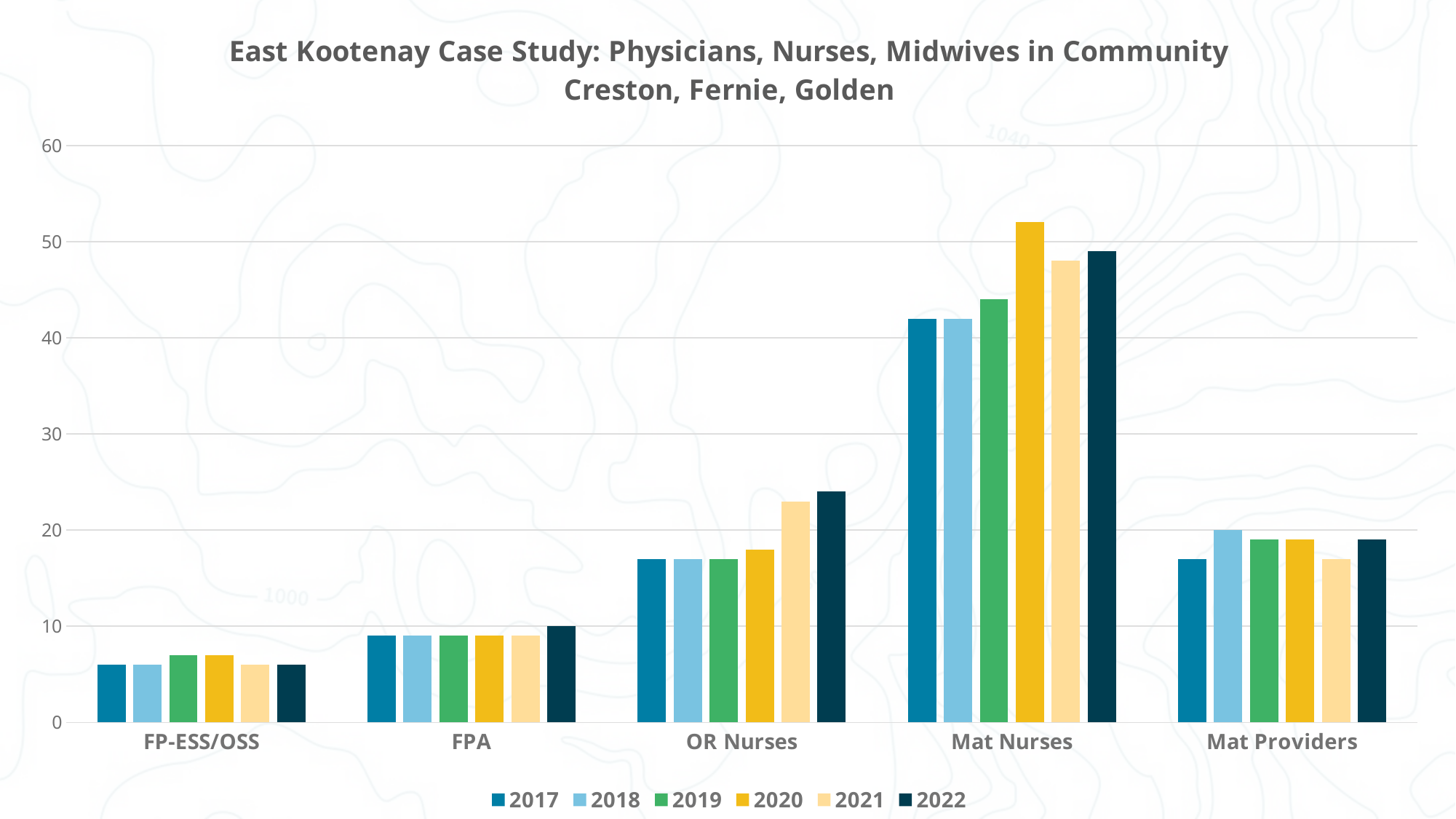
What kind of chart is shown on the slide? bar chart How many series does the legend list? 6 Is the value for Mat Nurses in 2020 greater or less than 50? greater How many categories are shown on the x axis? 5 For OR Nurses, is the 2022 bar larger or smaller than the 2017 bar? larger Within the Mat Nurses category, which year has the highest bar? 2020 Is the value for Mat Providers in 2017 greater or less than 20? less Is the value for FP-ESS/OSS in 2017 greater or less than 10? less Do the OR Nurses values rise or fall from 2017 to 2022? rise Which category has the lowest values overall? FP-ESS/OSS Which category has the tallest bars overall? Mat Nurses